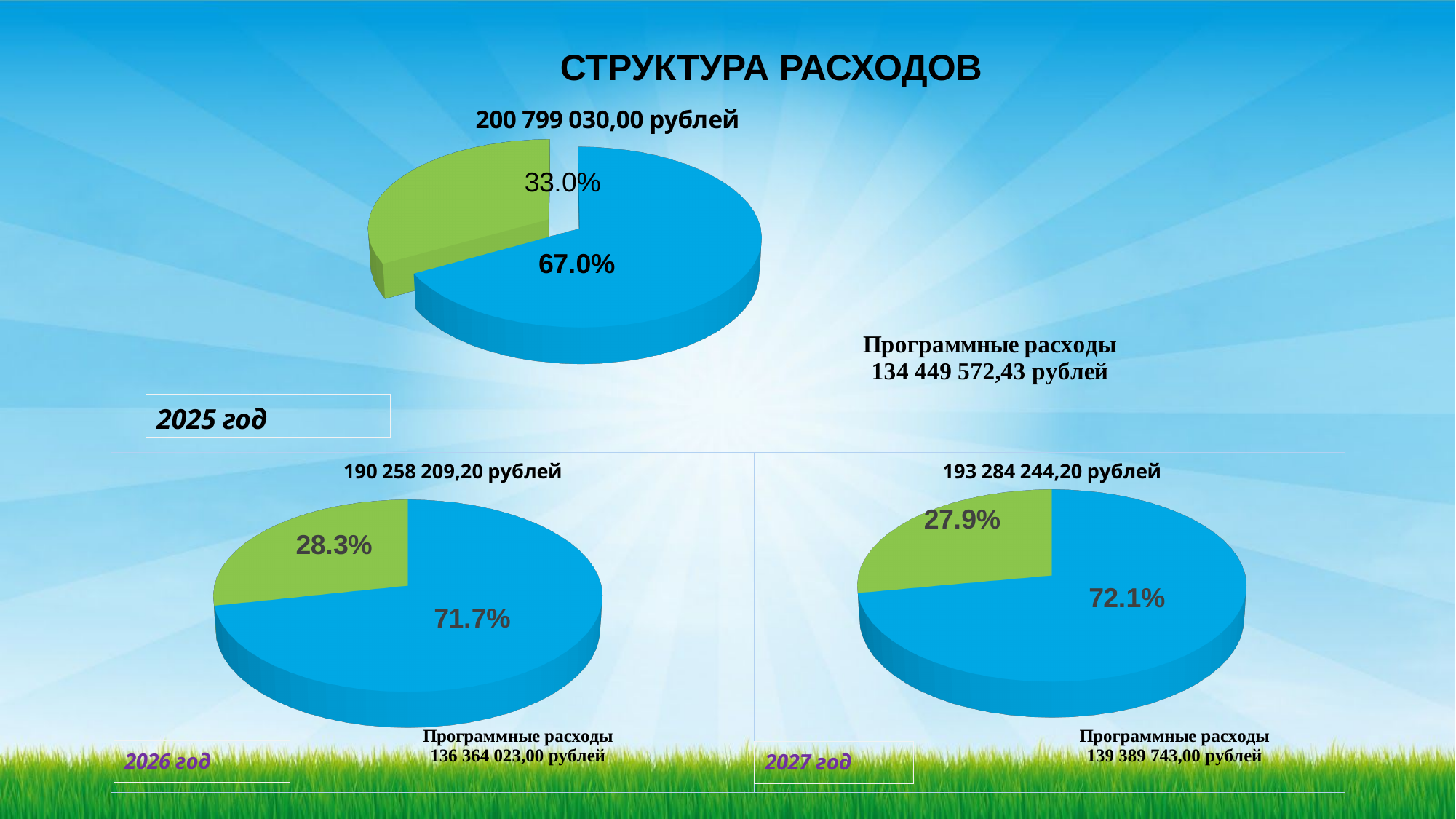
In the 2025 год pie chart, what share does the blue slice have? 67.0% In the 2026 год pie chart, what is the difference between the blue slice's share and the green slice's share? 43.4% In the 2025 год pie chart, what share does the green slice have? 33.0% In the 2026 год pie chart, which slice is larger, the blue one or the green one? the blue one In the 2027 год pie chart, what share does the green slice have? 27.9% How many pie charts are shown on the slide? 3 What is the title at the top of the slide? СТРУКТУРА РАСХОДОВ What kind of chart is shown for 2025 год? pie chart How many slices does the 2027 год pie chart have? 2 What total amount is shown as the title of the 2026 год pie chart? 190 258 209,20 рублей